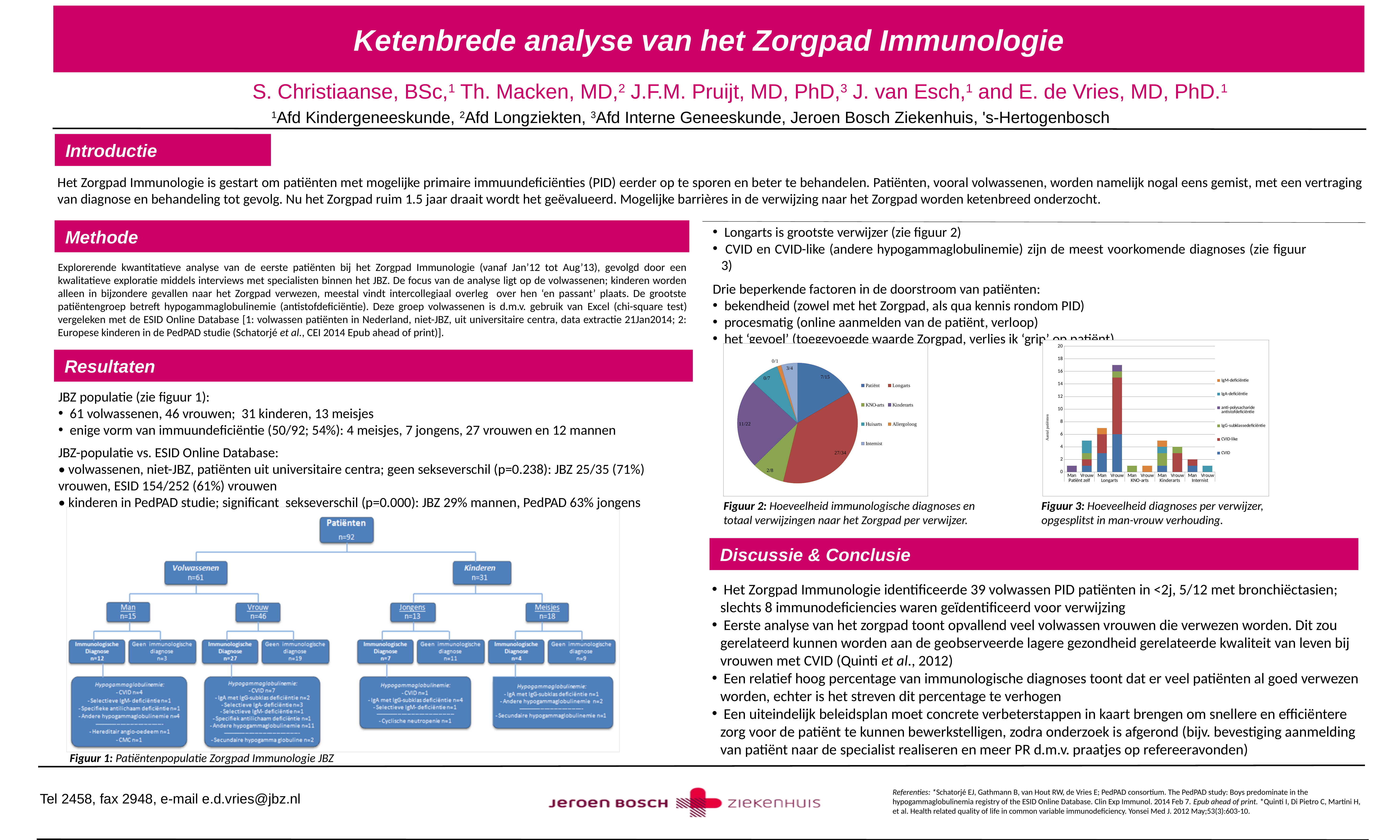
What kind of chart is Figuur 2? pie chart In Figuur 2, what label is shown on the Kinderarts slice? 11/22 In Figuur 3, which bar is the tallest? Vrouw, Longarts How many series does the legend of Figuur 3 list? 6 In Figuur 2, which referrer has the largest slice? Longarts In Figuur 3, is the total for Man under KNO-arts greater or less than 2? less In Figuur 2, what label is shown on the Huisarts slice? 0/7 In Figuur 3, is the total for Vrouw under Longarts greater or less than 10? greater What kind of chart is Figuur 3? bar chart In Figuur 2, what label is shown on the Patiënt slice? 7/15 How many slices does the pie chart in Figuur 2 have? 7 In Figuur 2, what label is shown on the Longarts slice? 27/34